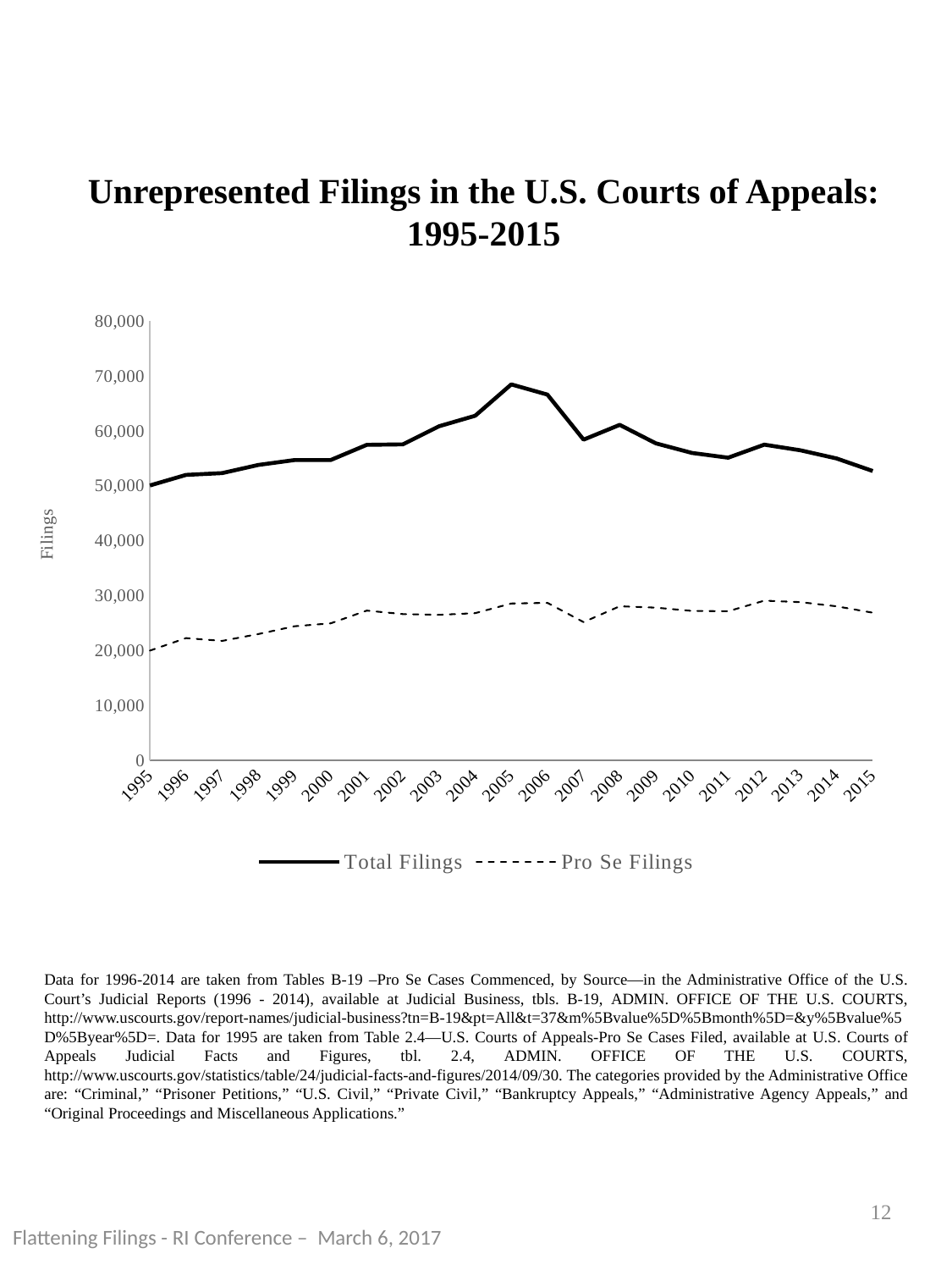
In which year is the Pro Se Filings series at its lowest value? 1995 Does the Total Filings series rise or fall between 2005 and 2007? Fall In 2010, which series has the larger value, Total Filings or Pro Se Filings? Total Filings Is the value for Pro Se Filings in 1995 greater or less than 30,000? less Is the value for Pro Se Filings in 2007 greater or less than 30,000? less How many years are plotted along the x axis? 21 How many series does the legend list? 2 Is the value for Total Filings in 2005 greater or less than 60,000? greater In which year does the Total Filings series reach its highest value? 2005 What is the label on the y axis? Filings What kind of chart is shown on the slide? Line chart